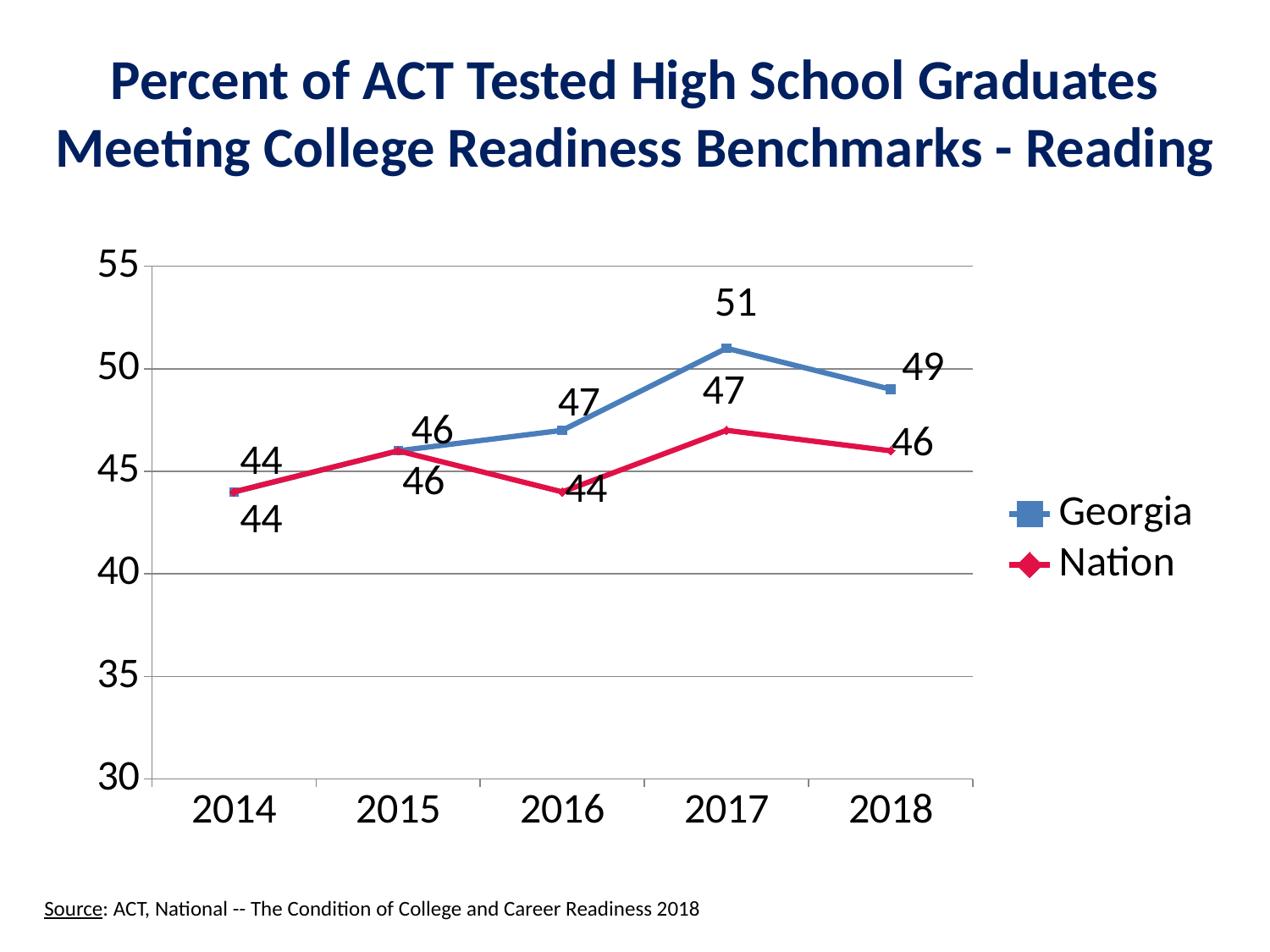
What colour is the Nation line? red What kind of chart is this? line chart What is the difference between Georgia and Nation in 2017? 4 Which is larger in 2018, Georgia or Nation? Georgia In which year is the Georgia value lowest? 2014 What is the value for Georgia in 2017? 51 Does the Georgia value rise or fall from 2014 to 2017? rise How many series does the legend list? 2 In which year is the Georgia value highest? 2017 How many years are shown on the x axis? 5 What is the value for Georgia in 2018? 49 What is the value for Nation in 2016? 44